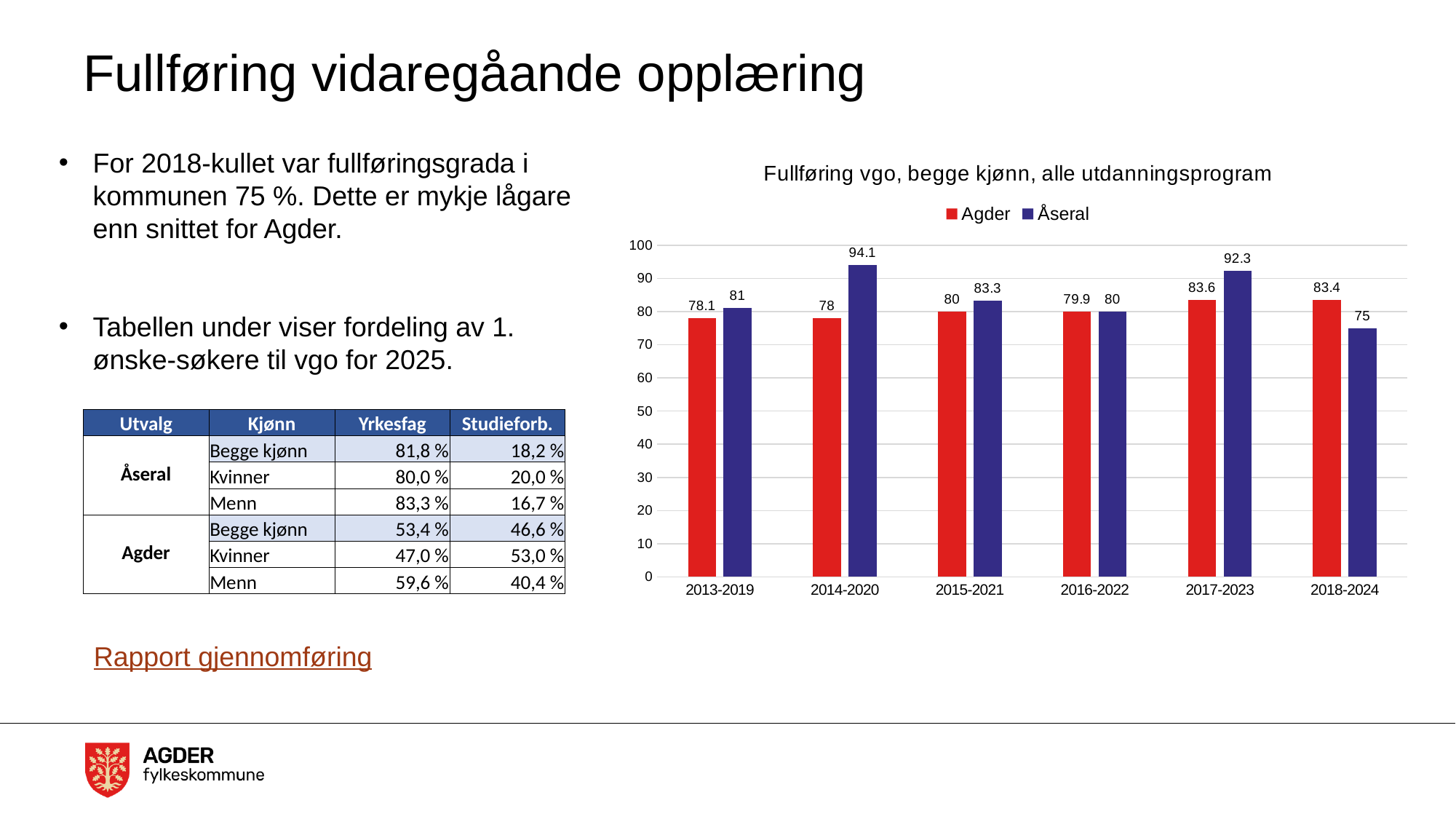
What is the value for Åseral in 2014-2020? 94.1 What is the difference between Åseral and Agder in 2014-2020? 16.1 What is the value for Agder in 2018-2024? 83.4 How many periods are shown on the x axis? 6 Which period has the lowest value for Åseral? 2018-2024 Which is larger in 2017-2023, Agder or Åseral? Åseral What kind of chart is shown? Bar chart How many series does the legend list? 2 What is the value for Åseral in 2018-2024? 75 What is the difference between Agder and Åseral in 2018-2024? 8.4 Which period has the lowest value for Agder? 2014-2020 Which period has the highest value for Åseral? 2014-2020